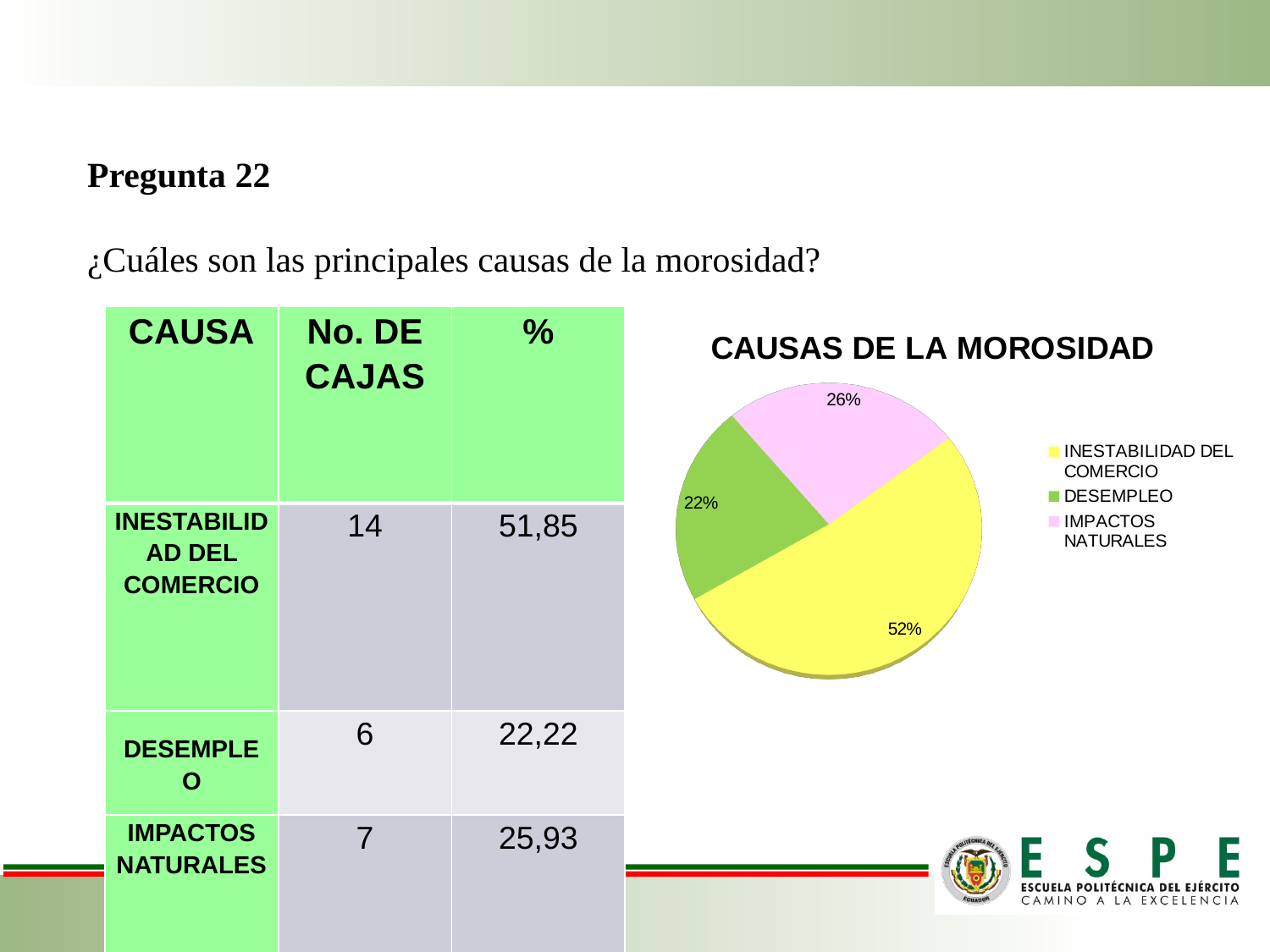
What percentage does the chart show for INESTABILIDAD DEL COMERCIO? 52% How many entries does the chart legend list? 3 What colour is the DESEMPLEO slice in the pie chart? green What percentage does the chart show for IMPACTOS NATURALES? 26% Which slice is larger, DESEMPLEO or IMPACTOS NATURALES? IMPACTOS NATURALES Which category has the smallest slice of the pie? DESEMPLEO What is the title of the chart? CAUSAS DE LA MOROSIDAD How many slices does the pie chart have? 3 What kind of chart is shown on the slide? pie chart Which category has the largest slice of the pie? INESTABILIDAD DEL COMERCIO What is the difference in percentage points between the INESTABILIDAD DEL COMERCIO slice and the IMPACTOS NATURALES slice? 26 What percentage does the chart show for DESEMPLEO? 22%